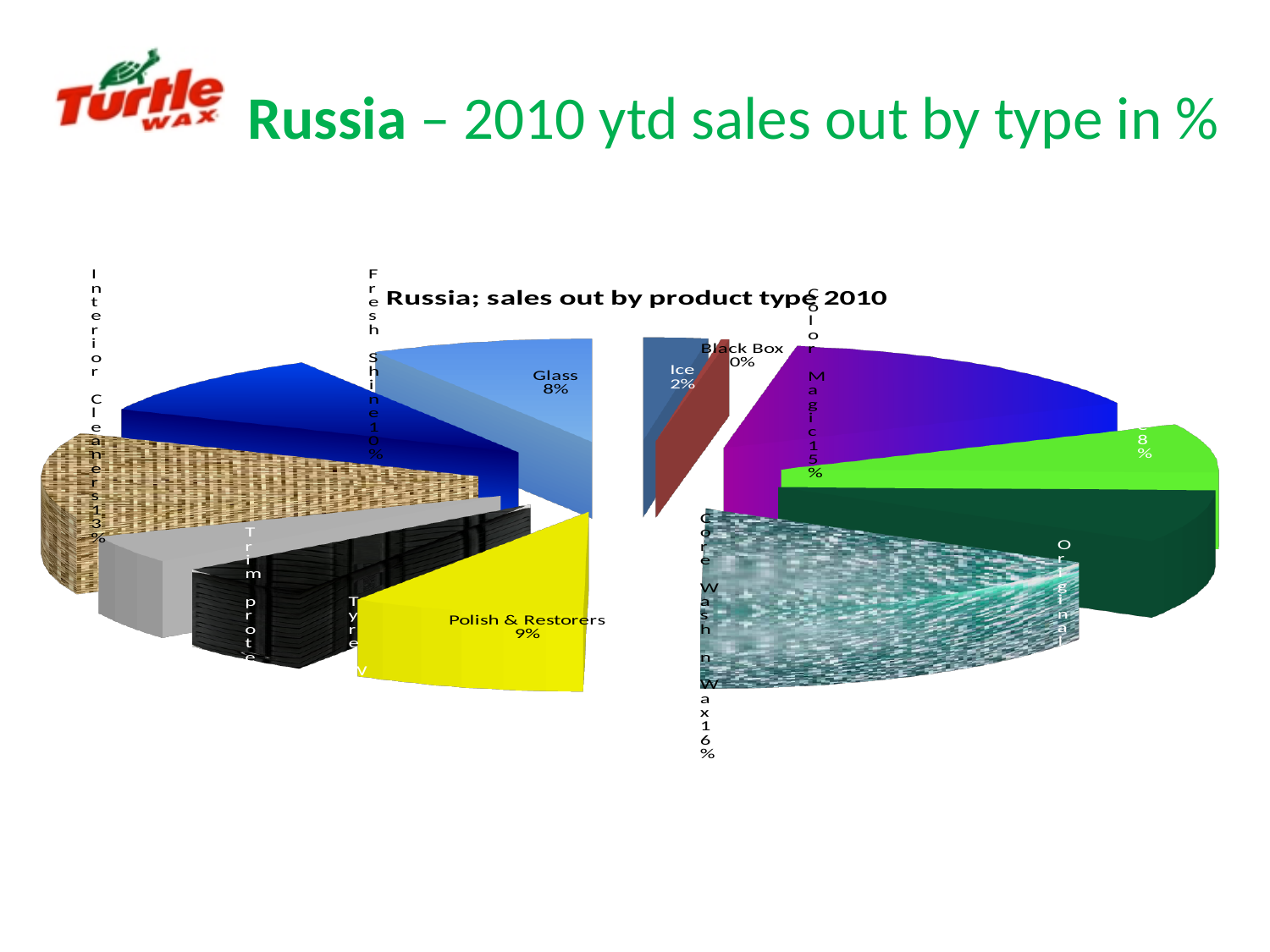
What share of sales does Magic account for? 15% What is the title of the chart? Russia; sales out by product type 2010 What share of sales does Ice account for? 2% What share of sales does Interior Cleaners account for? 13% What share of sales does Glass account for? 8% What share of sales does Polish & Restorers account for? 9% Which has the larger share, Glass or Ice? Glass What share of sales does Fresh Shine account for? 10% Which product type has the smallest share of sales? Black Box What share of sales does Black Box account for? 0% What is the difference in share between Magic and Glass? 7% What kind of chart is shown on the slide? Pie chart